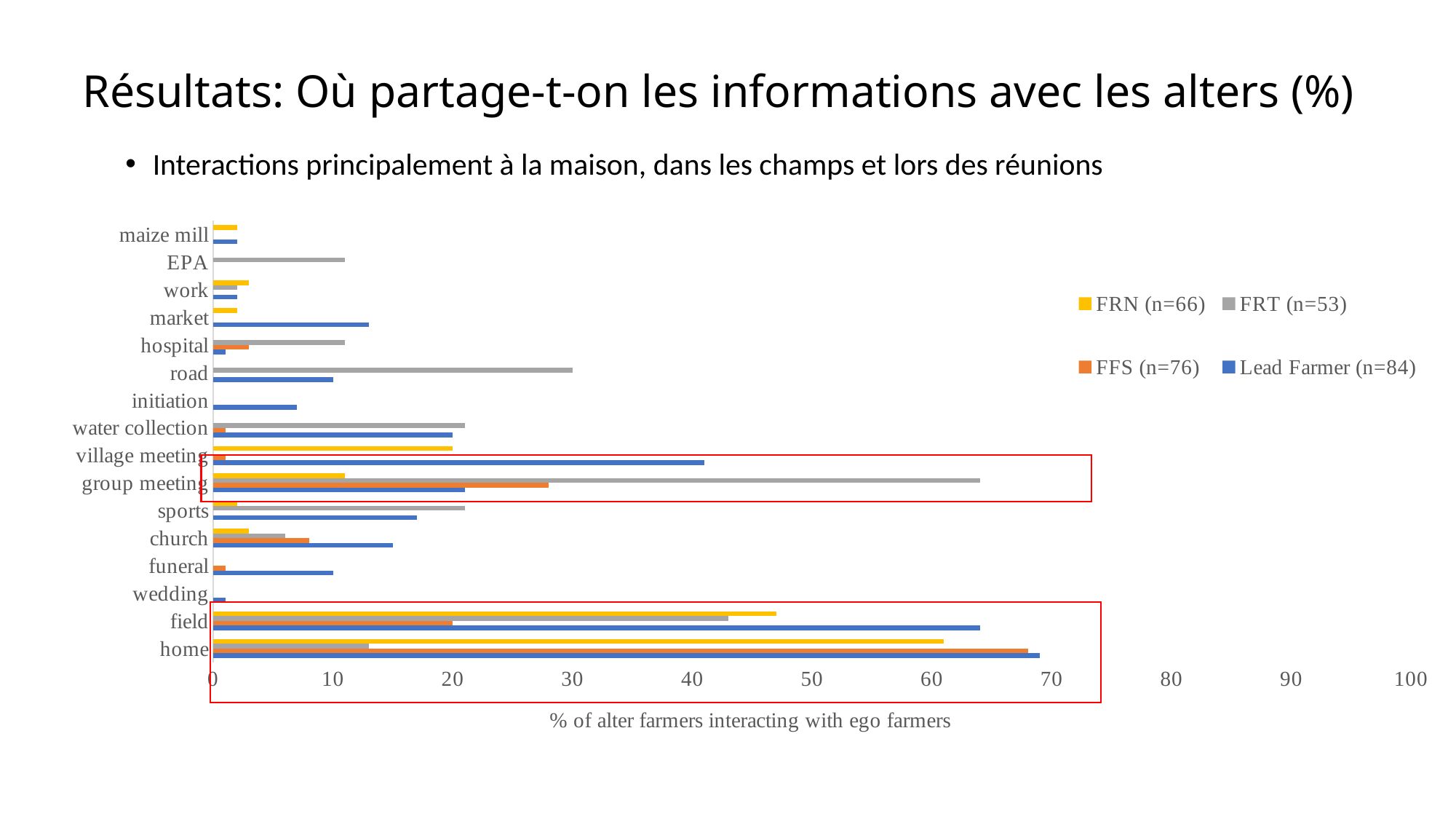
Which category has the highest value for the FRT (n=53) series? group meeting Is the value for Lead Farmer (n=84) at village meeting greater or less than 30? greater Which category has the highest value for the FRN (n=66) series? home How many series does the legend list? 4 What is the title of the horizontal axis? % of alter farmers interacting with ego farmers Is the value for Lead Farmer (n=84) at home greater or less than 60? greater Which category has the highest value for the FFS (n=76) series? home For the field category, which is larger: the FRN (n=66) value or the FFS (n=76) value? FRN (n=66) Is the value for FRT (n=53) at home greater or less than 20? less For the group meeting category, which is larger: the FRT (n=53) value or the FRN (n=66) value? FRT (n=53) How many location categories are shown on the vertical axis? 16 What kind of chart is shown on the slide? bar chart